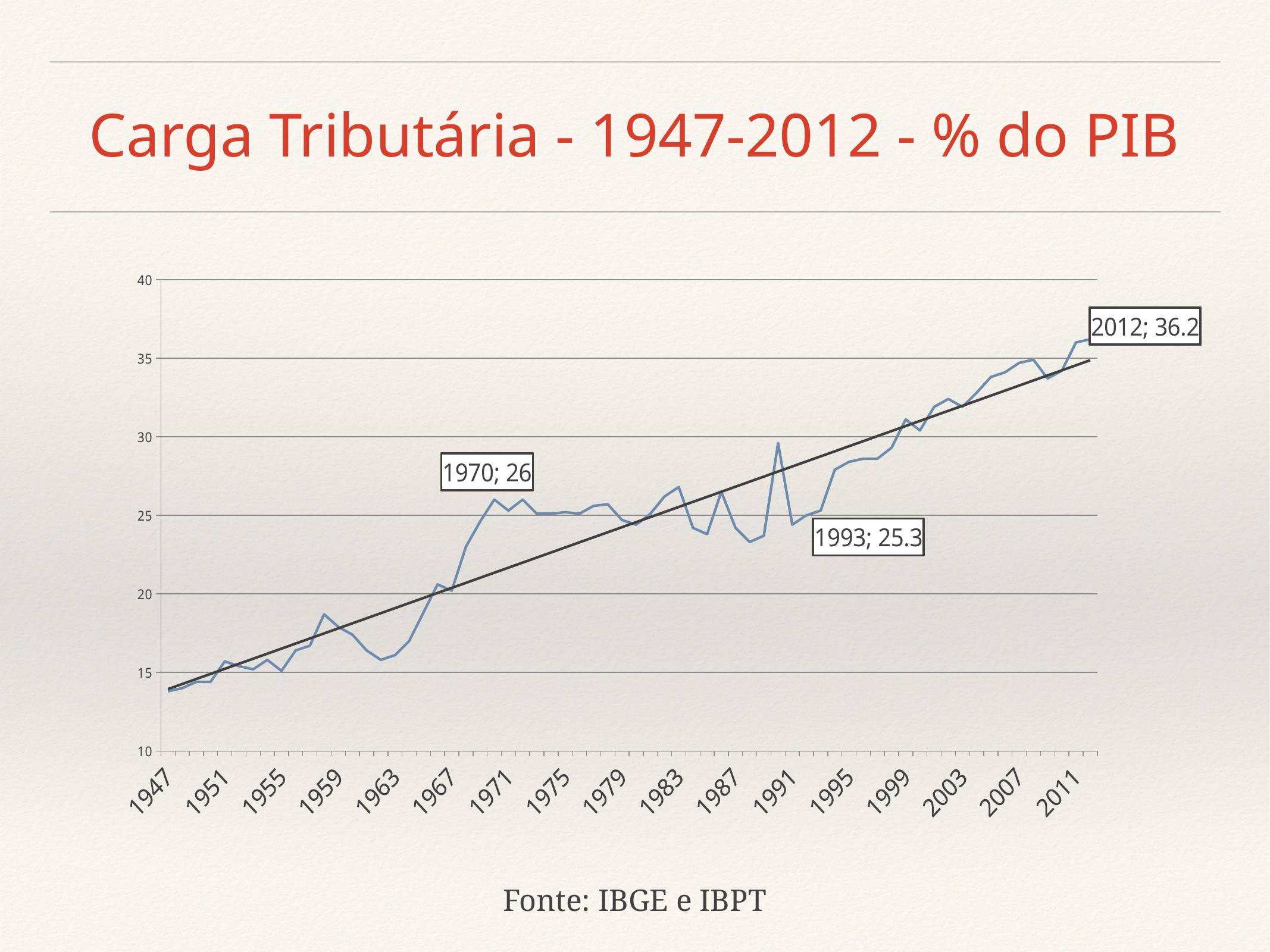
Which year has the larger labelled value, 1970 or 1993? 1970 What value is labelled for 2012? 36.2 Is the value for 1947 greater or less than 15? less What is the title of the chart? Carga Tributária - 1947-2012 - % do PIB Is the value for 2007 greater or less than 30? greater Which year has the highest value on the chart? 2012 What value is labelled for 1993? 25.3 Do the values generally rise or fall from 1947 to 2012? rise What is the difference between the labelled values for 2012 and 1993? 10.9 What kind of chart is shown on the slide? line chart What is the difference between the labelled values for 2012 and 1970? 10.2 What value is labelled for 1970? 26